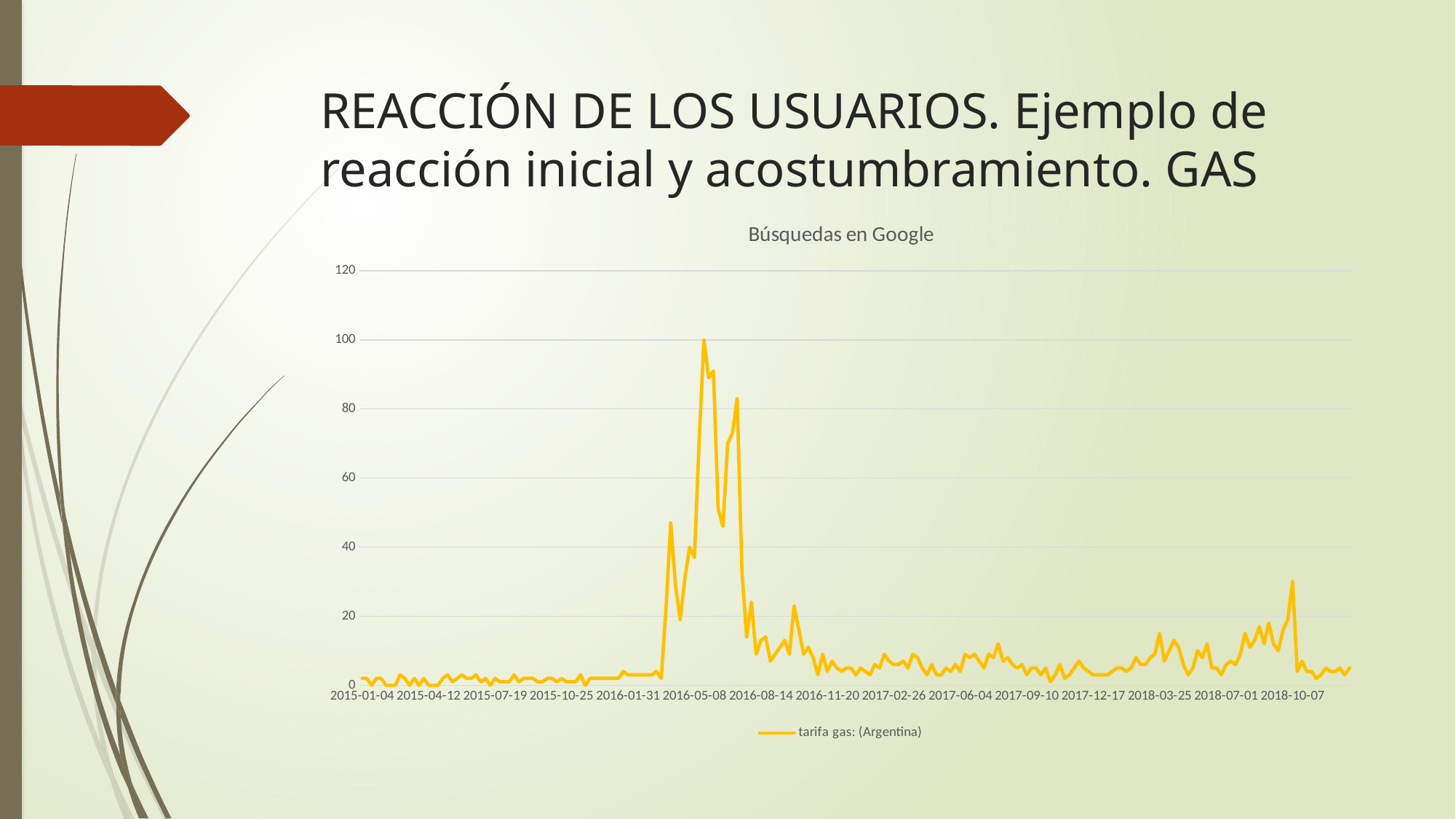
Which is larger: the peak of the line around 2016-05-08 or the peak around 2018-10-07? the peak around 2016-05-08 Is the highest value reached by the line during 2018 greater or less than 40? less What is the title of the chart? Búsquedas en Google Between 2016-01-31 and 2016-05-08, do the values generally rise or fall? rise Is the highest value reached by the line greater or less than 80? greater What kind of chart is shown on the slide? line chart What is the name of the series shown in the legend? tarifa gas: (Argentina) Is the value for tarifa gas: (Argentina) at 2015-04-12 greater or less than 20? less Between 2016-05-08 and 2016-11-20, do the values generally fall or rise? fall How many series does the legend list? 1